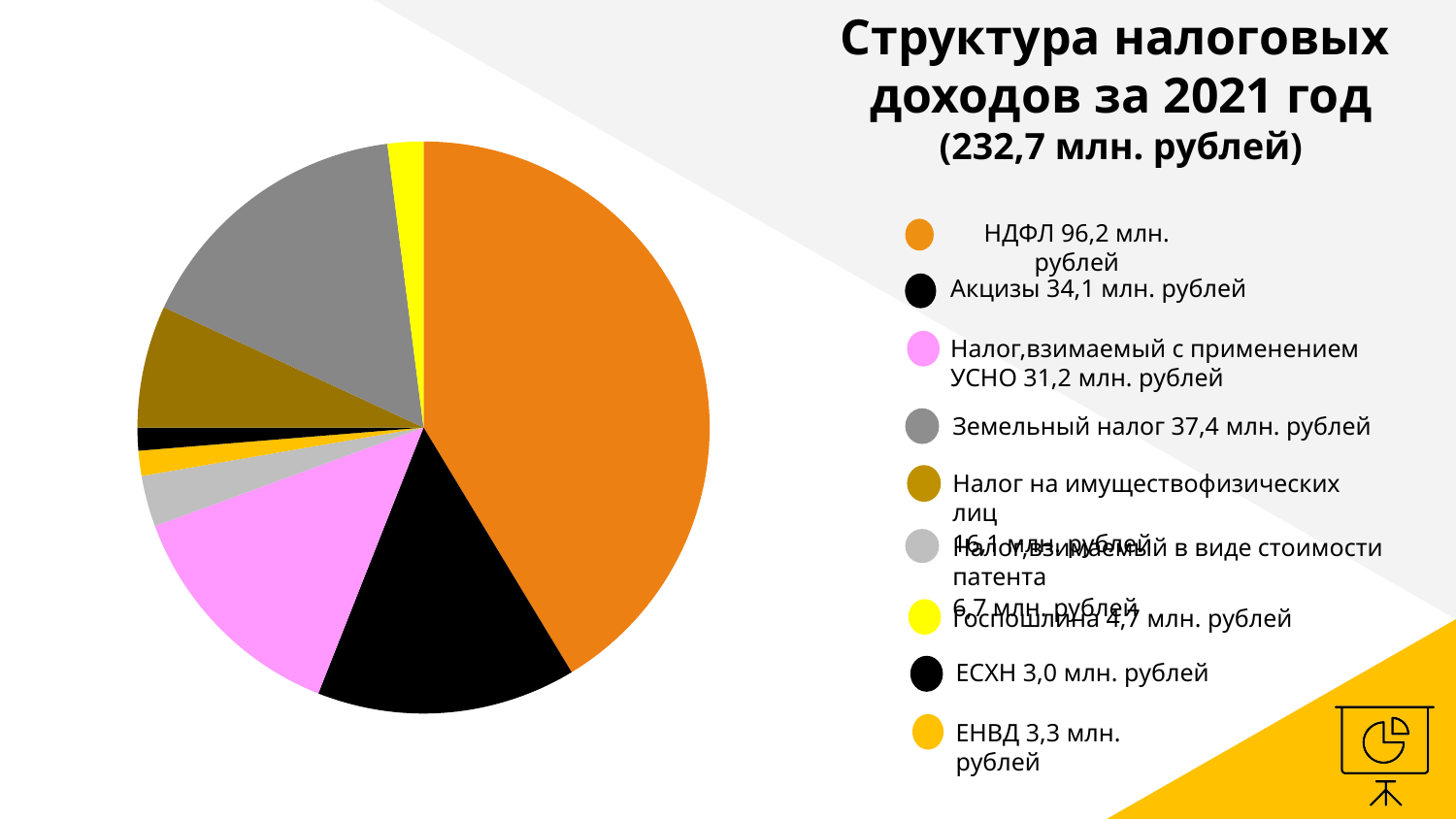
What is the value for Земельный налог? 37,4 млн. рублей What type of chart is shown on the slide? Pie chart What total amount is given in the chart title? 232,7 млн. рублей How many categories does the pie chart have? 9 Which category has the largest share of the pie? НДФЛ What is the value for Акцизы? 34,1 млн. рублей Which is larger, Земельный налог or Налог, взимаемый с применением УСНО? Земельный налог Which category has the smallest value? ЕСХН What is the value for Госпошлина? 4,7 млн. рублей What colour is the slice for НДФЛ? Orange What is the value for НДФЛ? 96,2 млн. рублей What is the difference between НДФЛ and Акцизы? 62,1 млн. рублей